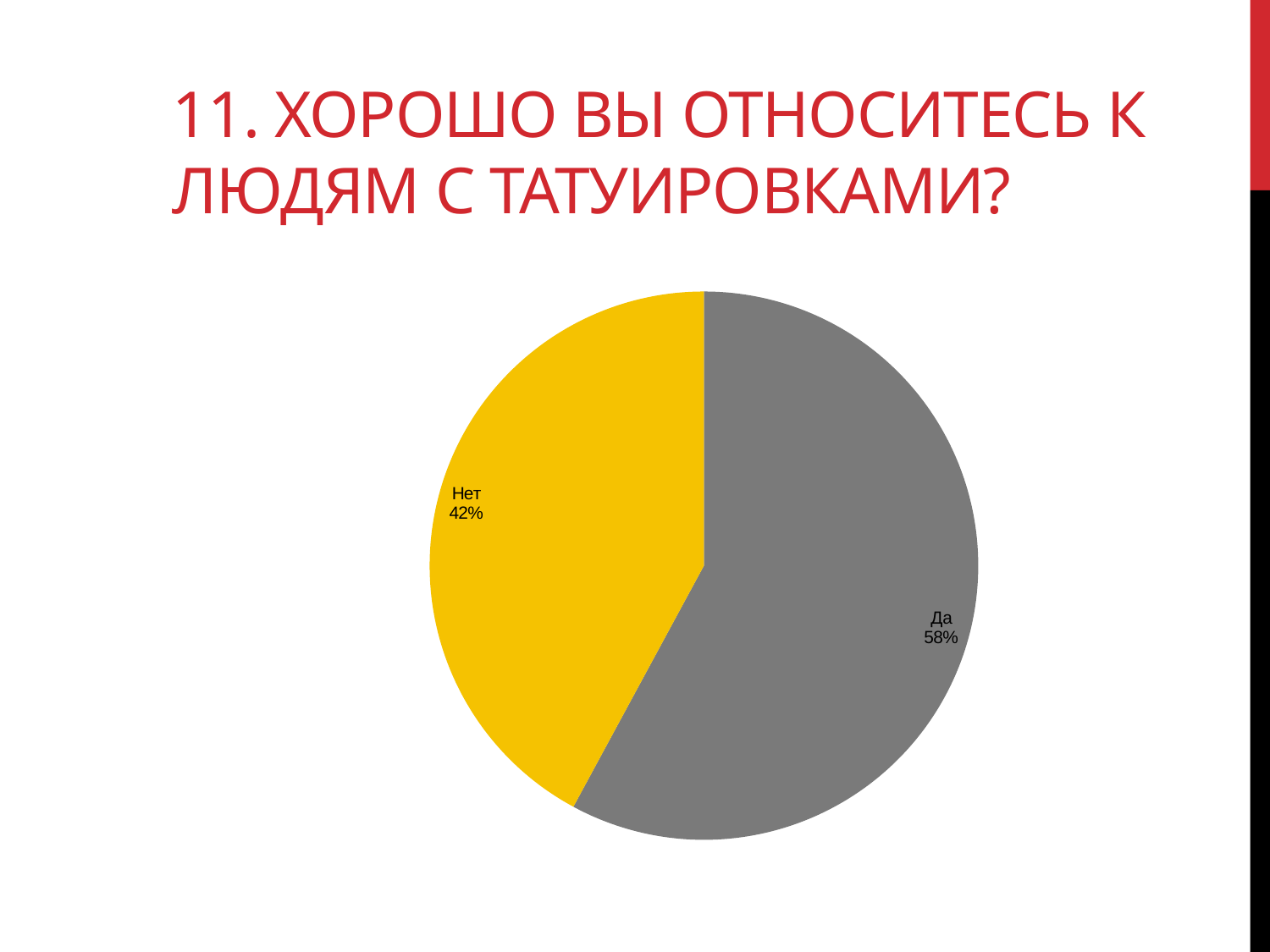
What kind of chart is shown on the slide? pie chart What colour is the "Нет" slice? yellow What share of the pie does the "Нет" slice represent? 42% Which is larger, the "Да" slice or the "Нет" slice? Да What share of the pie does the "Да" slice represent? 58% What colour is the "Да" slice? grey What is the difference in percentage points between the "Да" and "Нет" slices? 16 Which slice is the smallest in the pie chart? Нет How many slices does the pie chart have? 2 Which slice is the largest in the pie chart? Да